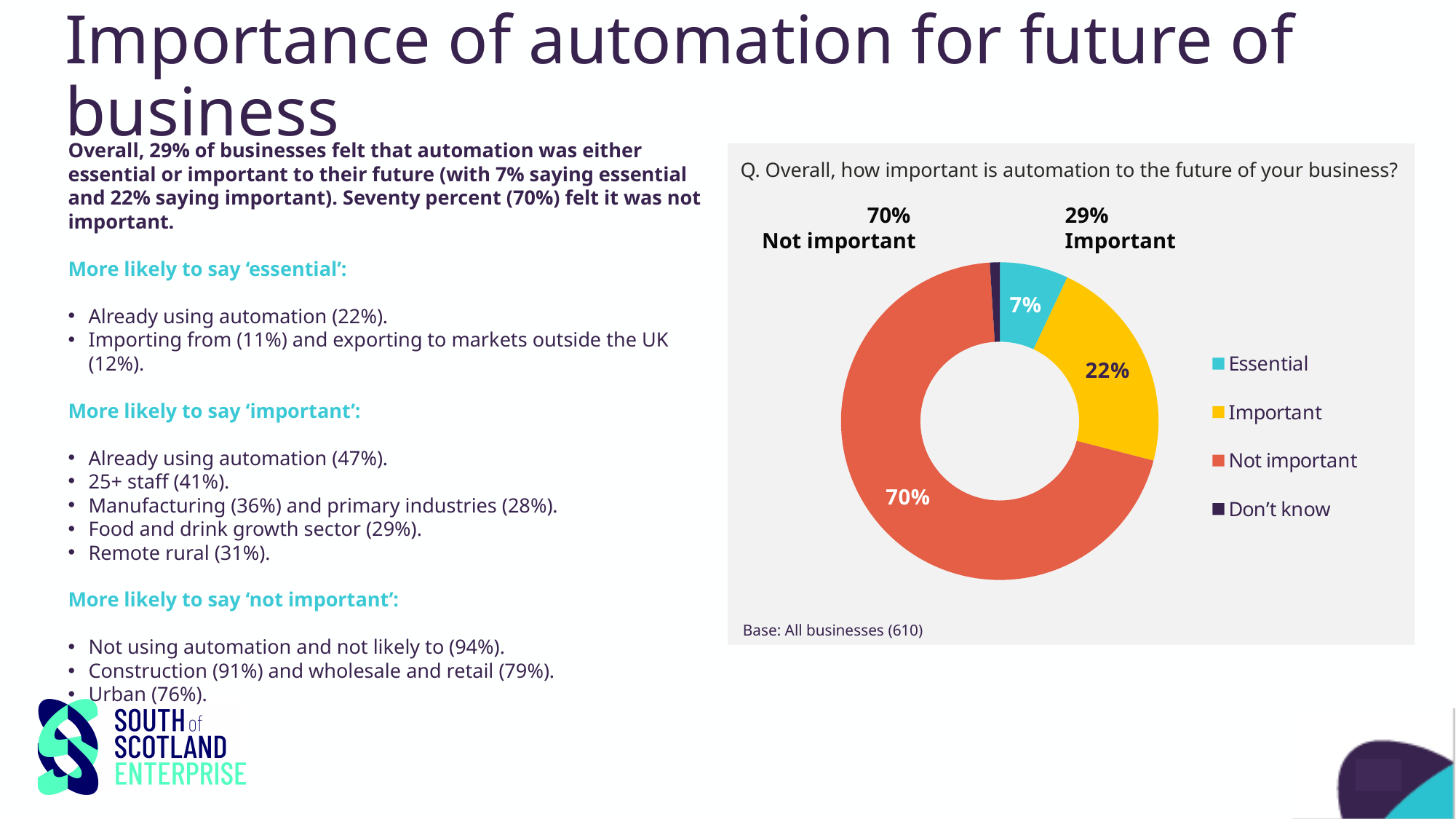
What percentage of businesses said automation is 'Essential' to the future of their business? 7% What kind of chart is shown on the slide? Pie chart (donut) What question is the chart based on, as shown in its title? Q. Overall, how important is automation to the future of your business? Which category has the smallest share of the pie? Don't know What is the combined percentage for 'Essential' and 'Important' shown above the chart? 29% Which category has the largest share of the pie? Not important What percentage of businesses said automation is 'Important'? 22% What percentage of businesses said automation is 'Not important'? 70% How many categories does the legend list? 4 What colour represents 'Not important' in the chart? Red/orange What is the difference in percentage points between 'Not important' and 'Important'? 48 percentage points Which is larger, the share for 'Essential' or the share for 'Important'? Important